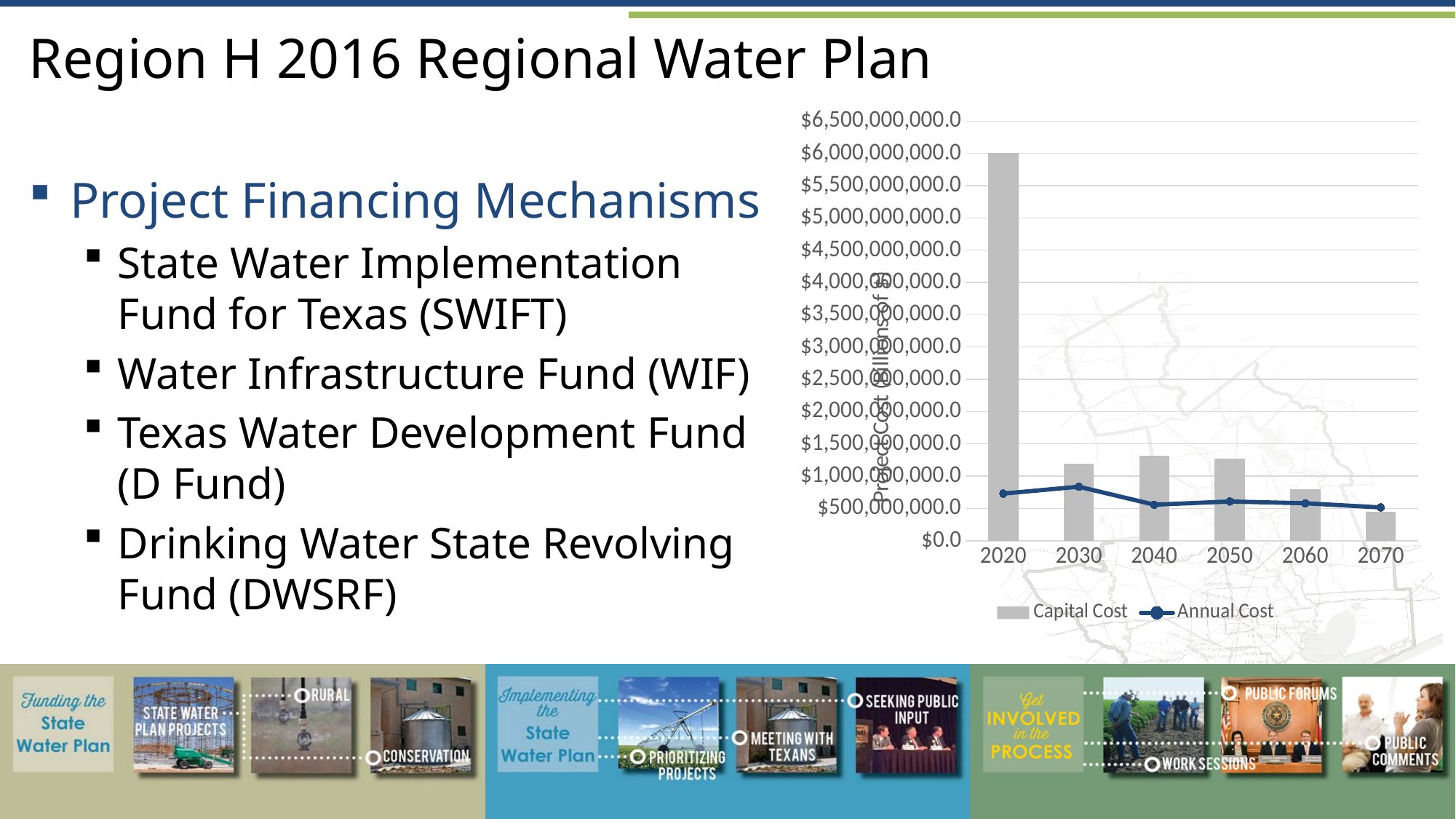
How many series does the chart legend list? 2 Which year has the larger Capital Cost, 2060 or 2070? 2060 Is the Annual Cost for 2020 greater or less than $500,000,000.0? greater Which series is shown as a line in the chart? Annual Cost Which year has the highest Capital Cost? 2020 How many years are shown on the x axis of the chart? 6 Which year has the highest Annual Cost? 2030 Which year has the lowest Capital Cost? 2070 Is the Capital Cost for 2030 greater or less than $1,000,000,000.0? greater What kind of chart is shown on the slide? Combination bar and line chart Is the Capital Cost for 2020 greater or less than $5,500,000,000.0? greater